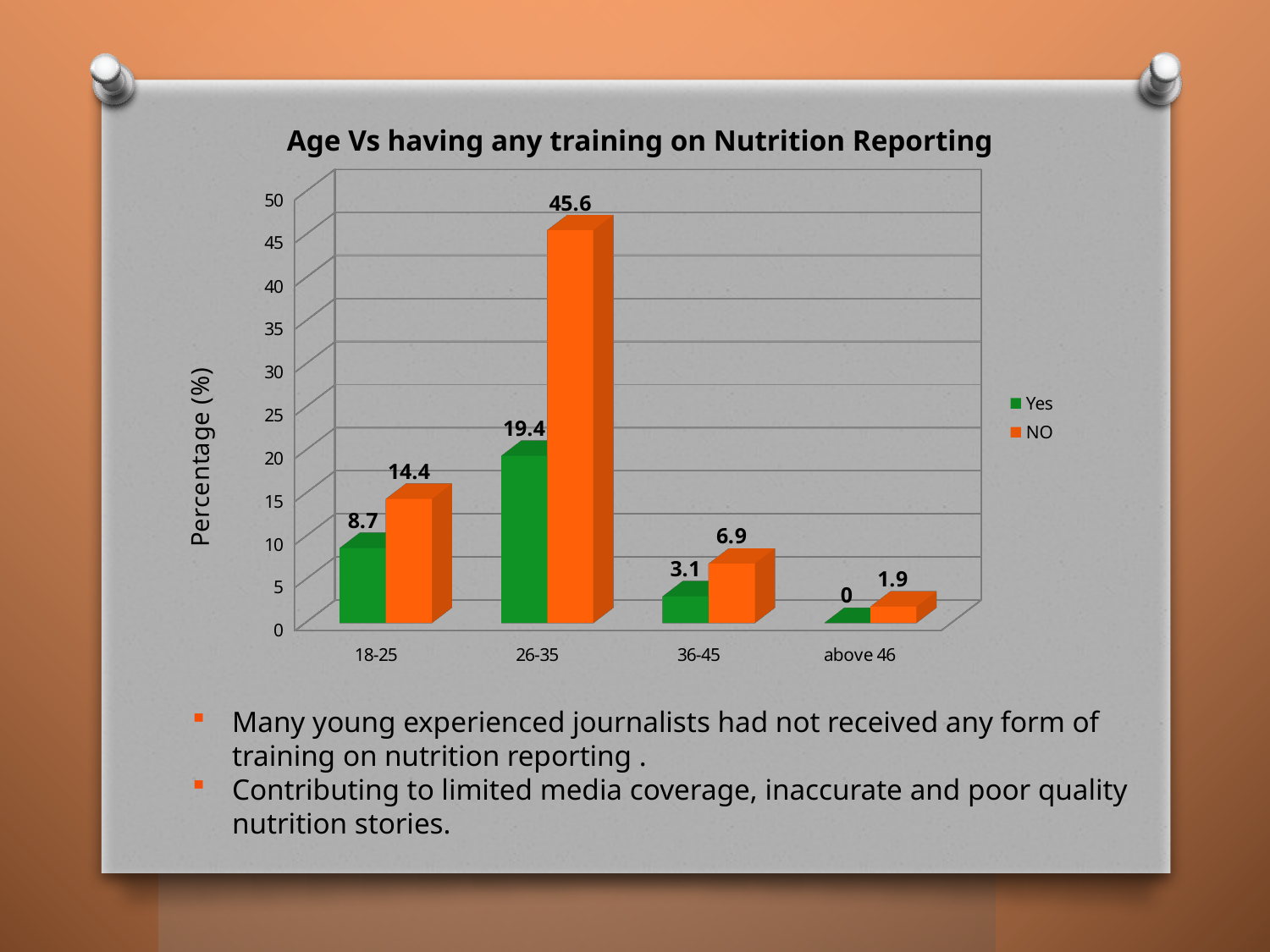
What is the title of the chart? Age Vs having any training on Nutrition Reporting Which is larger for the 36-45 age group, the Yes value or the NO value? NO How many age groups are shown on the x axis? 4 How many series does the legend list? 2 Which age group has the highest NO value? 26-35 What is the label on the vertical axis? Percentage (%) Which age group has the lowest Yes value? above 46 What kind of chart is shown on the slide? bar chart What is the Yes value for the 18-25 age group? 8.7 What is the NO value for the 26-35 age group? 45.6 What is the Yes value for the above 46 age group? 0 What is the difference between the NO and Yes values for the 26-35 age group? 26.2